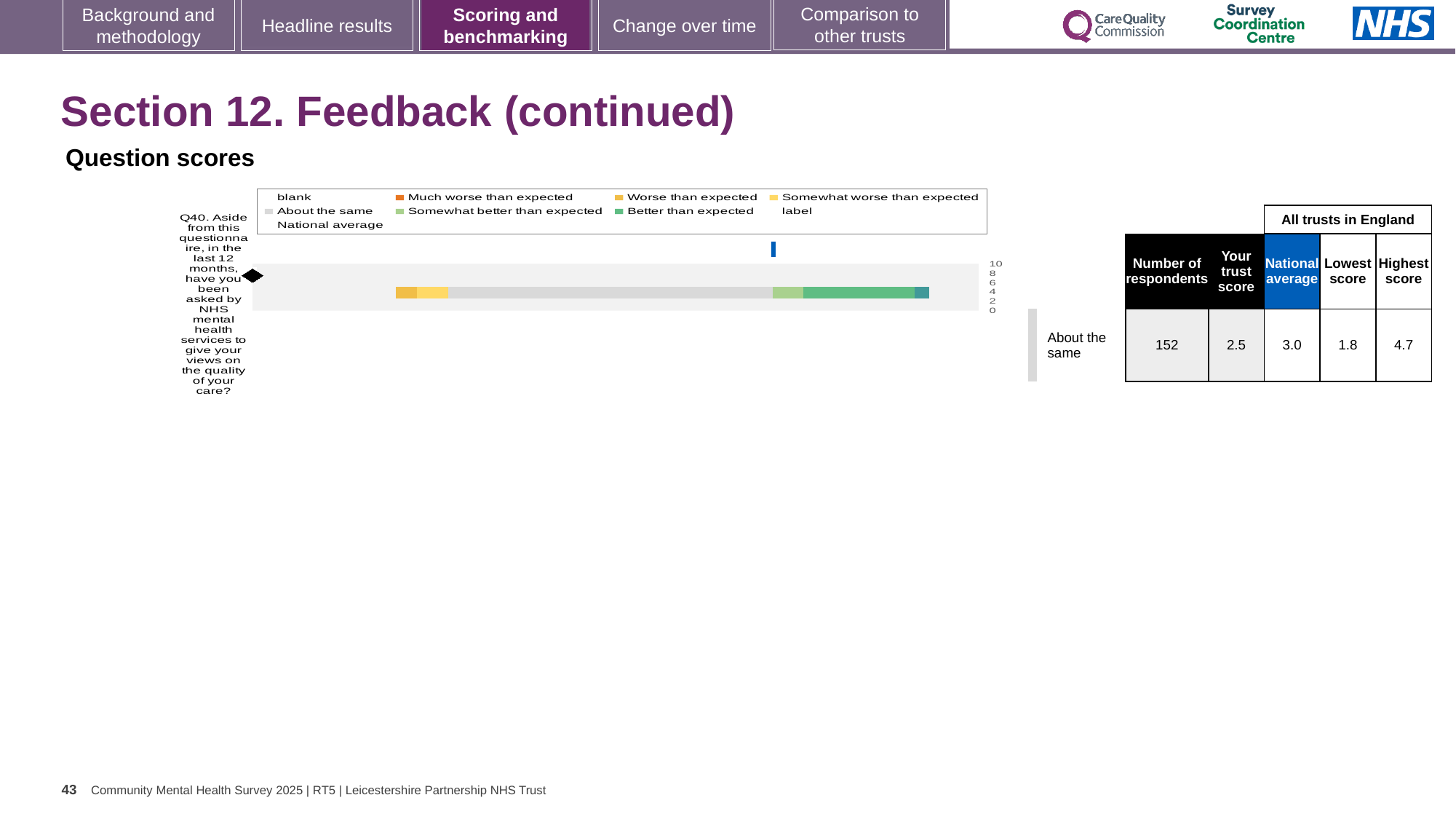
How many entries does the chart legend list? 9 According to the table beside the chart, how many respondents answered Q40? 152 According to the table beside the chart, what is the national average for Q40? 3.0 What is the difference between the highest score (4.7) and the lowest score (1.8) for Q40 in the table beside the chart? 2.9 According to the table beside the chart, what is the lowest score among all trusts in England for Q40? 1.8 Which question is plotted in the chart? Q40. Aside from this questionnaire, in the last 12 months, have you been asked by NHS mental health services to give your views on the quality of your care? According to the table beside the chart, what is the highest score among all trusts in England for Q40? 4.7 What kind of chart is shown on the slide? bar chart According to the table beside the chart, what is the trust score for Q40? 2.5 How many questions (categories) are plotted in the chart? 1 Is the trust score for Q40 (2.5) larger or smaller than the national average (3.0)? smaller What colour does the legend use for 'Much worse than expected'? orange